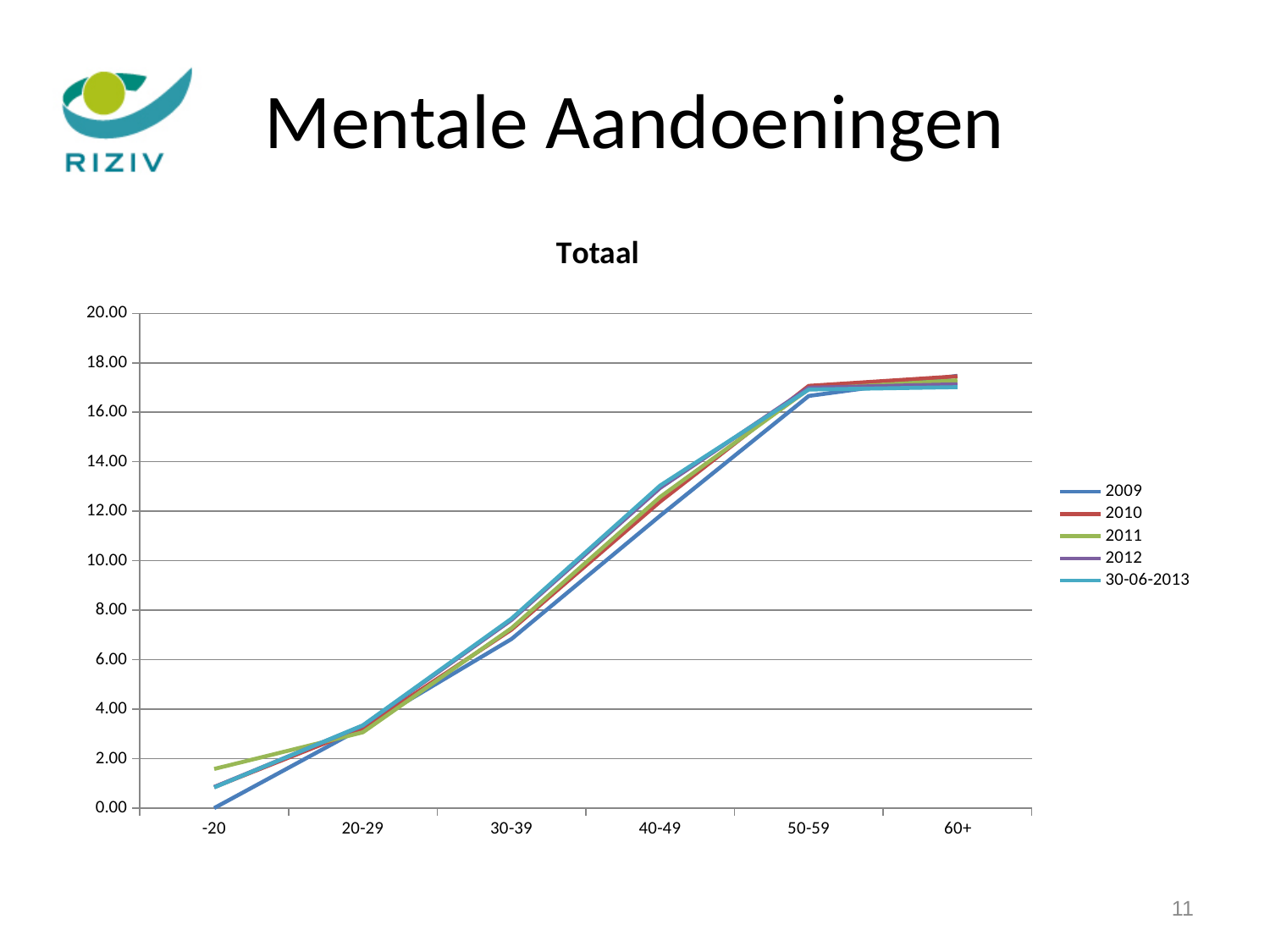
What type of chart is shown on the slide? line chart How many series does the legend list? 5 Is the value for the 2011 series at -20 greater or less than 2.00? less Is the value for the 30-06-2013 series at 40-49 greater or less than 12.00? greater What is the value for the 2009 series at -20? 0.00 What is the title of the chart? Totaal Do the values for the 2009 series rise or fall from -20 to 60+? rise How many age categories are shown on the x axis? 6 At 40-49, which series has the larger value: 2009 or 30-06-2013? 30-06-2013 For the 2009 series, which age category has the lowest value? -20 Is the value for the 2009 series at 50-59 greater or less than 16.00? greater At -20, which series has the larger value: 2009 or 2011? 2011